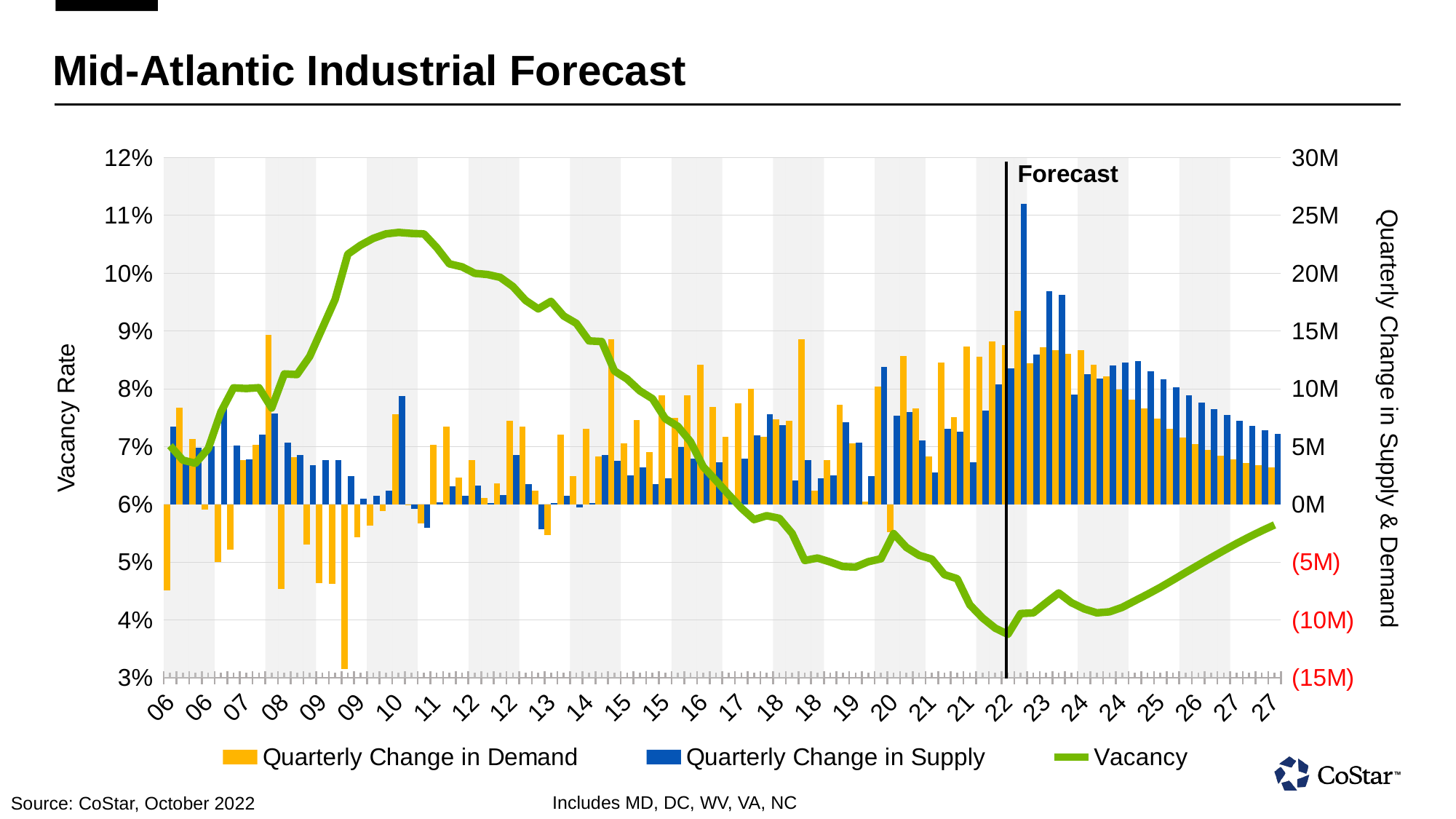
Does the Vacancy line rise or fall between 2011 and 2022? fall What does the vertical black line on the chart mark? Forecast What is the title of the chart? Mid-Atlantic Industrial Forecast Is the Vacancy value at the end of 2027 greater or less than 5%? greater How many series does the legend list? 3 Which is higher, the Vacancy rate around 2010 or the Vacancy rate at the forecast line in 2022? 2010 Does the Vacancy line rise or fall over the forecast period from 2022 to 2027? rise Is the lowest Quarterly Change in Demand bar (in 2009) above or below (10M)? below Is the peak value of the Vacancy line (around 2010) greater or less than 10%? greater What kind of chart is this? Combined bar and line chart